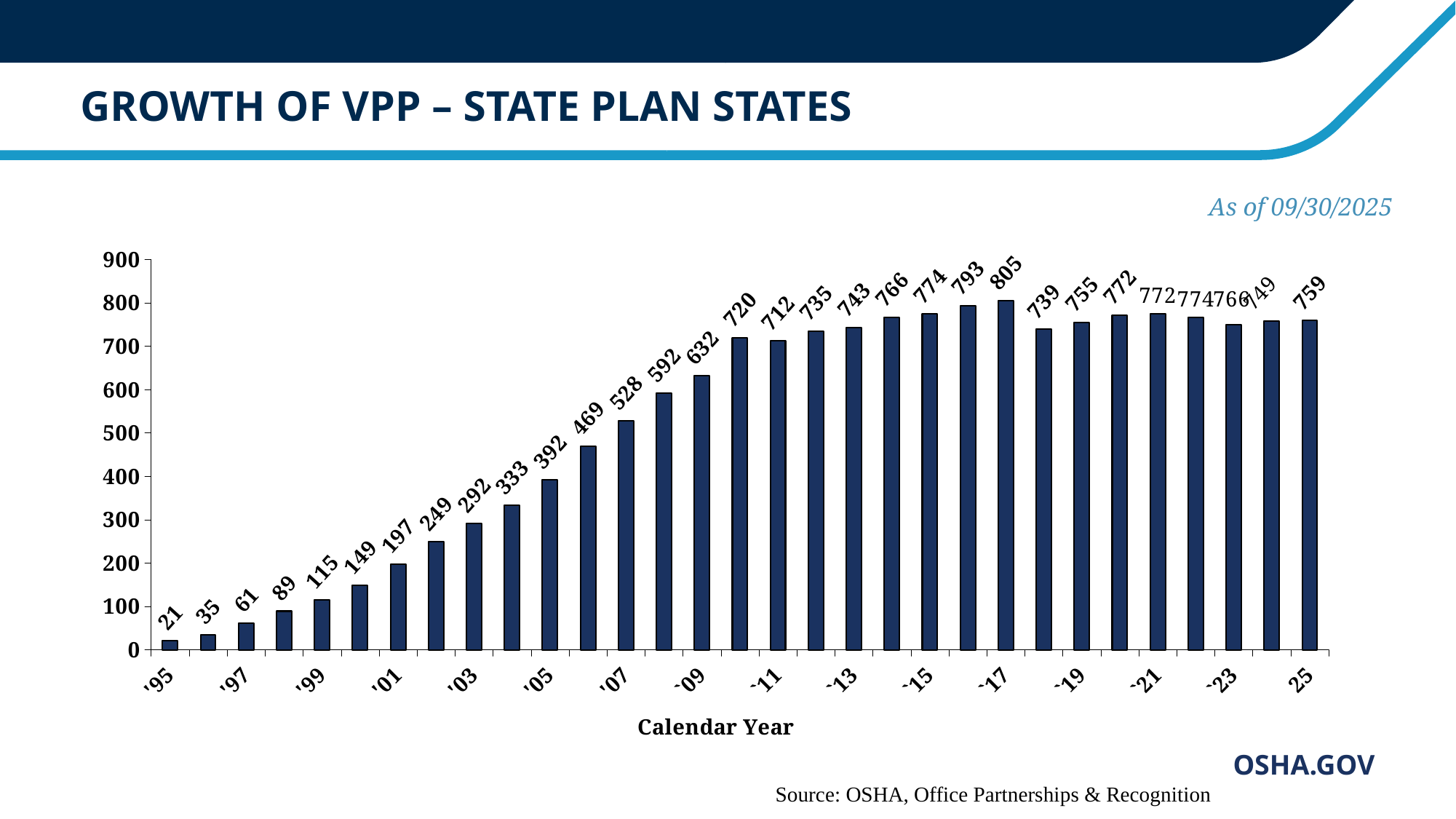
Is the value for '07 greater or less than 500? greater Which year has the highest value? '17 Do the values generally rise or fall from '95 to '17? rise What is the value for '25? 759 What is the value for '95? 21 What is the value for '05? 392 What is the value for '17? 805 Which is larger, the value for '09 or the value for '11? '11 What is the difference between the values for '17 and '19? 50 Which year has the lowest value? '95 What is the x-axis title of the chart? Calendar Year What type of chart is shown on the slide? bar chart